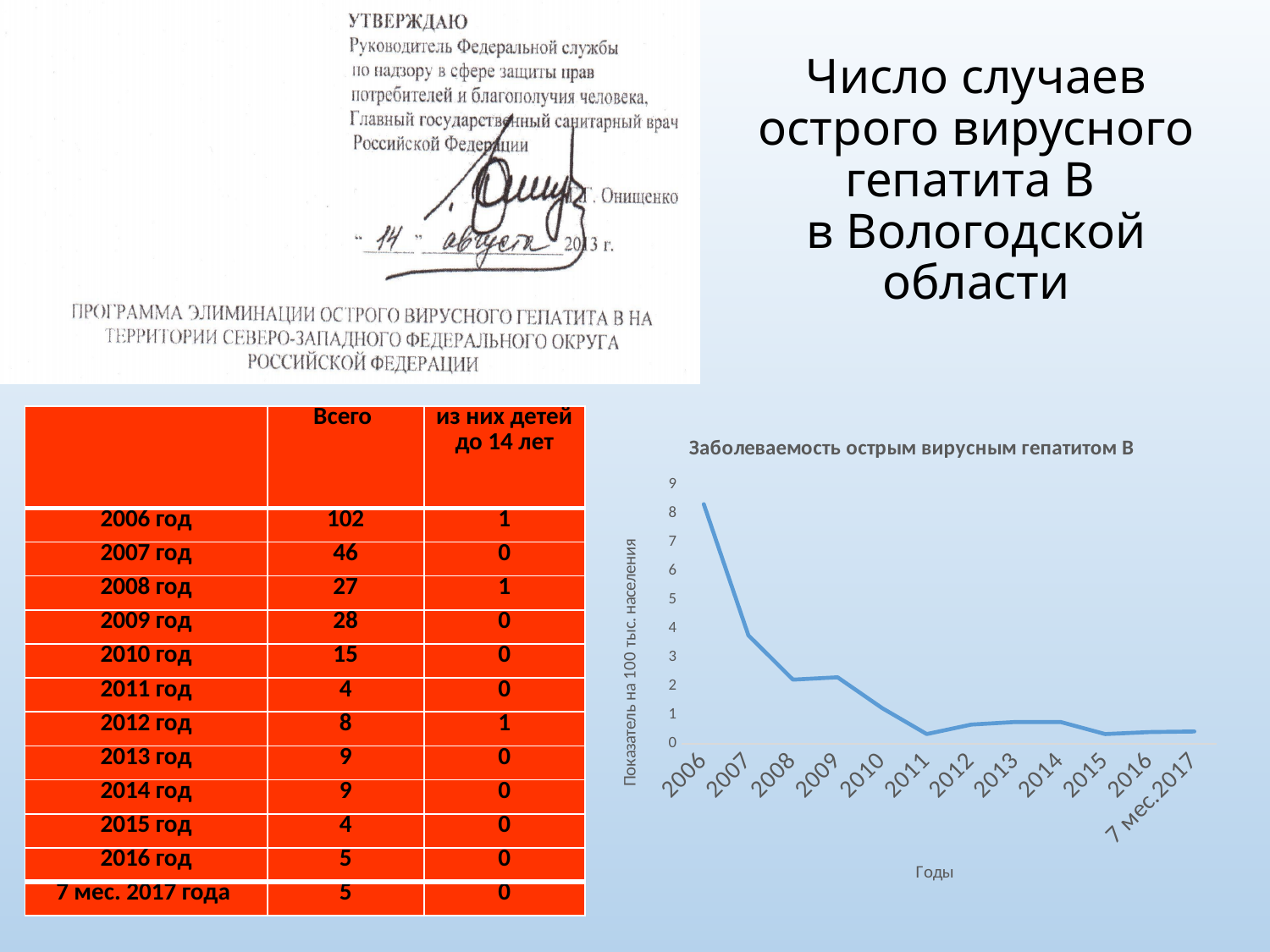
How many points are plotted along the x axis of the chart? 12 What is the title of the chart? Заболеваемость острым вирусным гепатитом В Is the value for 2007 greater or less than 3? greater What is the label of the vertical axis of the chart? Показатель на 100 тыс. населения Is the value for 2008 greater or less than 3? less Which is larger on the chart, the value for 2008 or the value for 2010? 2008 Is the value for 2006 greater or less than 8? greater Which is larger on the chart, the value for 2006 or the value for 2007? 2006 Do the values on the chart generally rise or fall from 2006 to 7 мес.2017? fall What kind of chart is shown on the slide? line chart Which year has the highest value on the chart? 2006